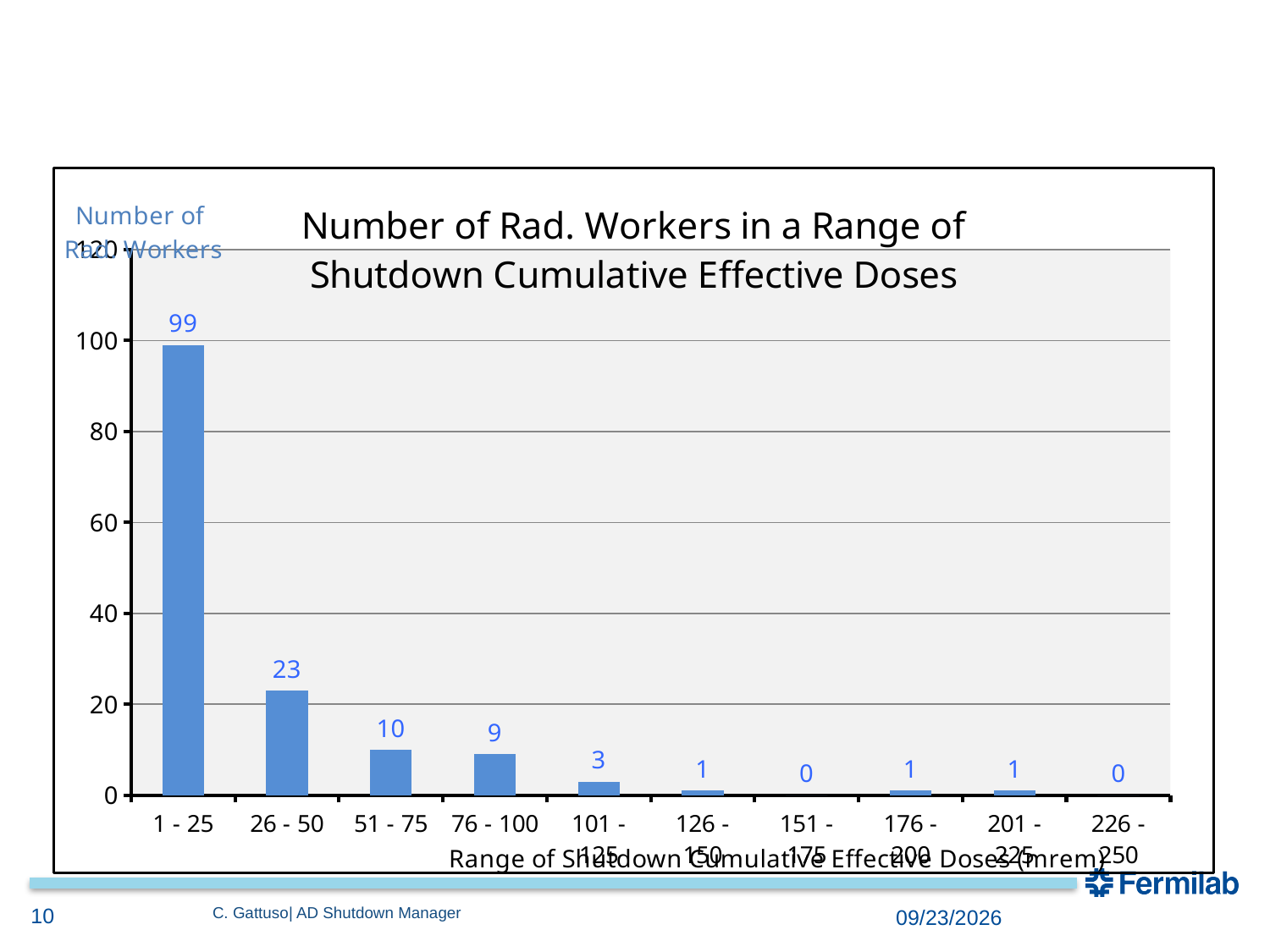
Which dose range has the highest number of rad workers? 1 - 25 What kind of chart is shown on the slide? bar chart What is the title of the chart? Number of Rad. Workers in a Range of Shutdown Cumulative Effective Doses Is the value for the 1 - 25 range greater or less than 80? greater What is the value for the 26 - 50 dose range? 23 How many dose range categories are shown on the x axis? 10 How many rad workers fall in the 51 - 75 range? 10 Which is larger, the value for 51 - 75 or the value for 76 - 100? 51 - 75 How many rad workers are in the 1 - 25 mrem dose range? 99 What is the difference between the number of workers in the 1 - 25 range and the 26 - 50 range? 76 Do the values rise or fall as the dose range increases along the x axis? fall What is the value for the 76 - 100 range? 9